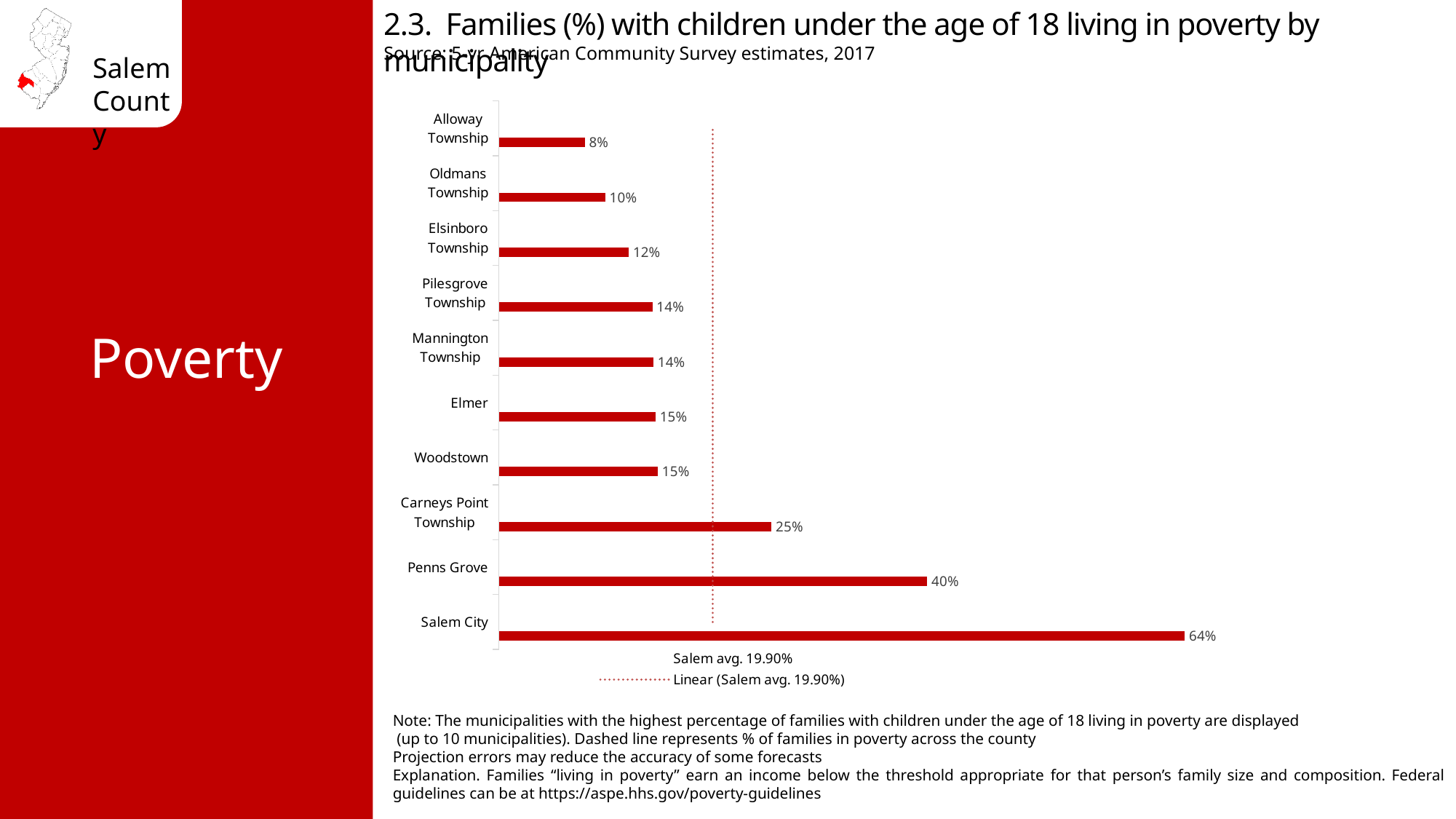
What is the value shown for Penns Grove? 40% What percentage of families with children under 18 are living in poverty in Salem City? 64% What kind of chart is shown on the slide? Bar chart How many municipalities are shown in the chart? 10 Which municipality has the highest percentage of families with children under 18 living in poverty? Salem City What is the difference between the values for Salem City and Penns Grove? 24% What is the value shown for Carneys Point Township? 25% What is the difference between the values for Elsinboro Township and Oldmans Township? 2% Which has a higher value, Carneys Point Township or Woodstown? Carneys Point Township What Salem County average value does the dashed line in the legend represent? 19.90% What is the value shown for Alloway Township? 8% Which municipality has the lowest percentage of families with children under 18 living in poverty? Alloway Township